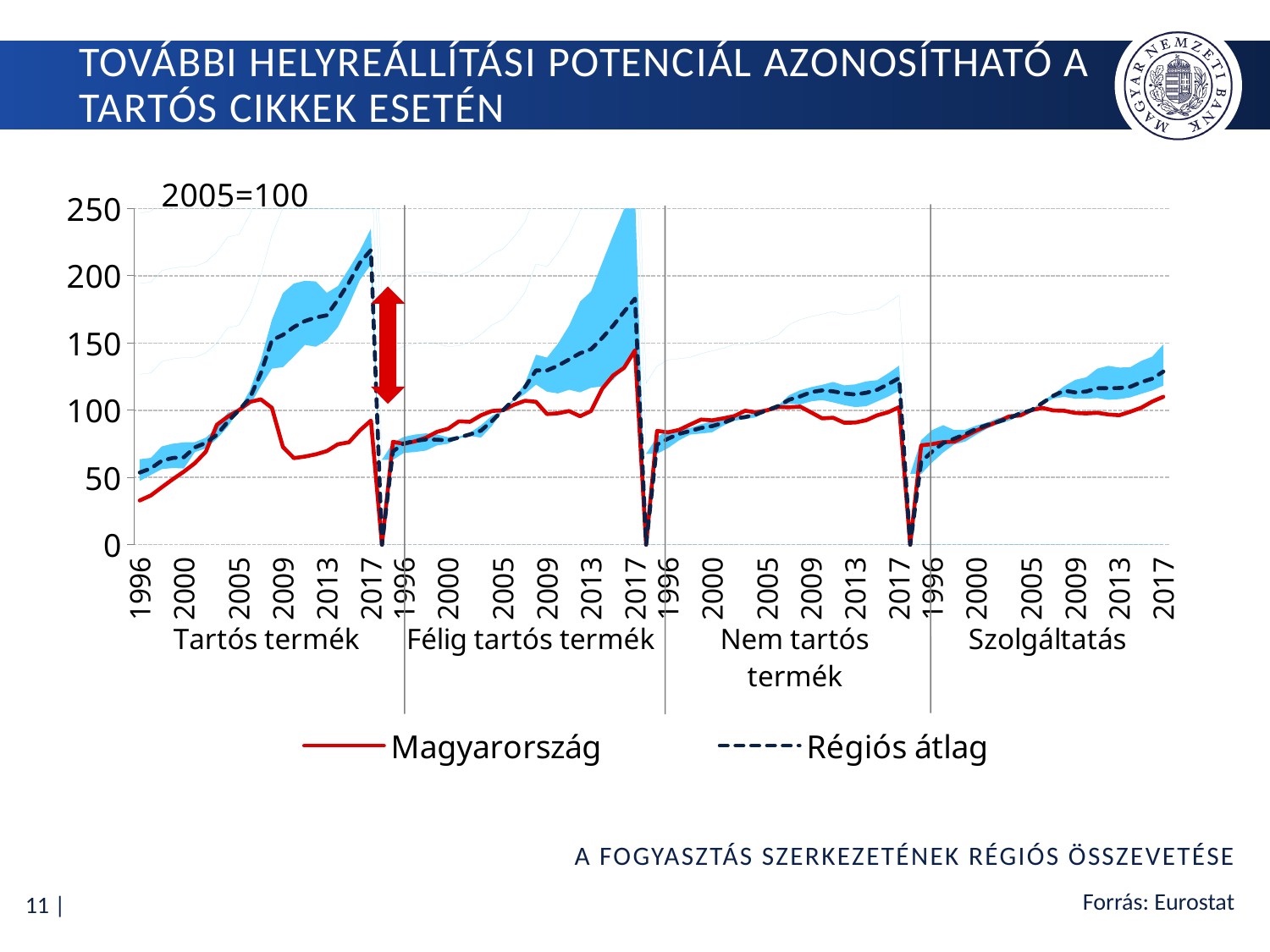
How many product categories (panels) are shown along the x axis? 4 In the Tartós termék panel, is the value for Magyarország in 2017 greater or less than 100? less In the Szolgáltatás panel, is the value for Régiós átlag in 2017 greater or less than 100? greater In the Tartós termék panel, which series is higher in 2017, Magyarország or Régiós átlag? Régiós átlag How many series does the legend list? 2 Which series is drawn as a dashed line in the legend? Régiós átlag In the Tartós termék panel, is the value for Magyarország in 1996 greater or less than 50? less In the Tartós termék panel, does the Magyarország line rise or fall between 2005 and 2009? fall What base year and index value is stated above the chart? 2005=100 What kind of chart is shown on the slide? line chart